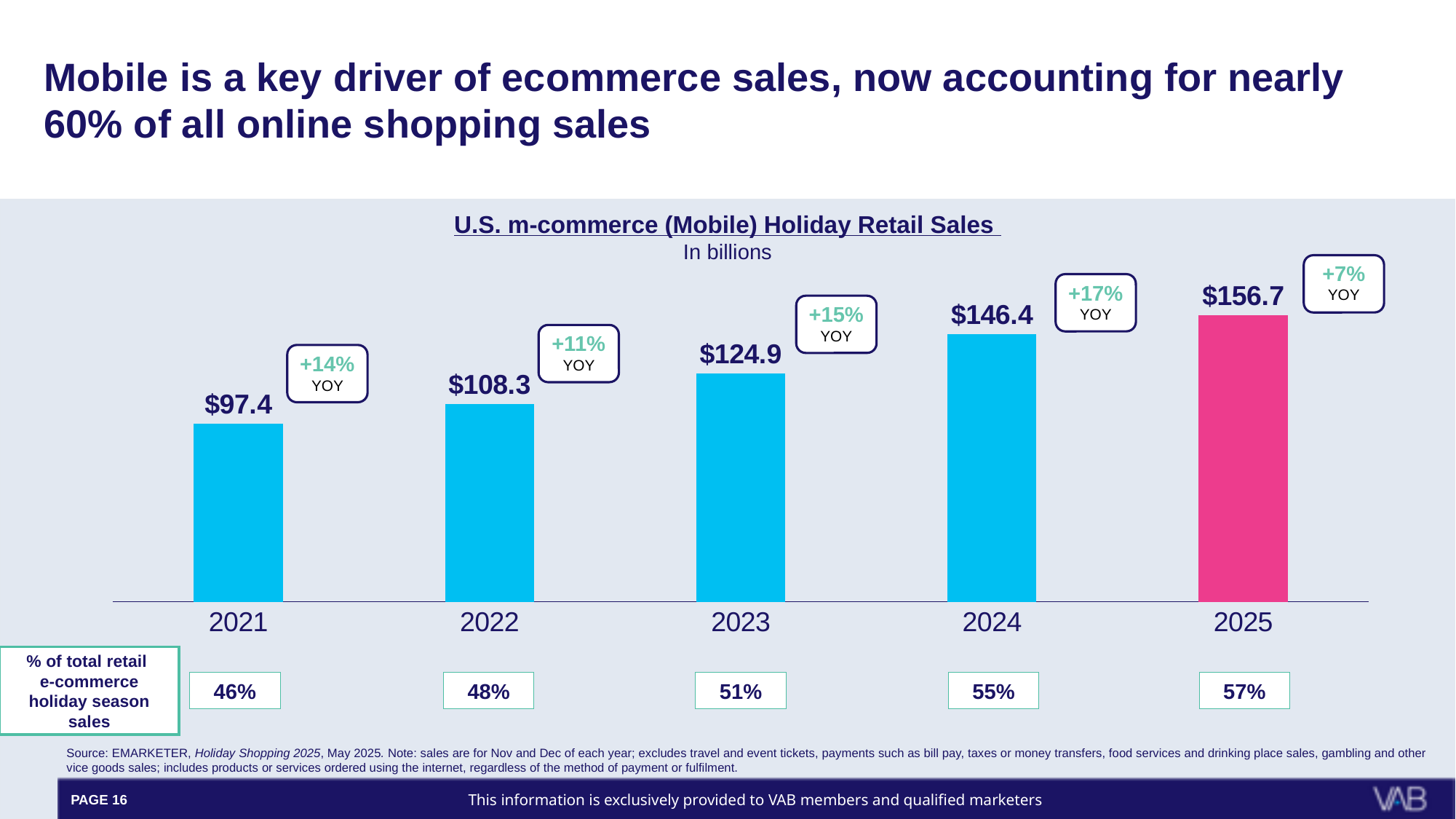
What is the value for 2023 in the U.S. m-commerce (Mobile) Holiday Retail Sales chart? $124.9 Which is larger in the U.S. m-commerce (Mobile) Holiday Retail Sales chart, the value for 2022 or the value for 2024? 2024 Which year has the lowest value in the U.S. m-commerce (Mobile) Holiday Retail Sales chart? 2021 What is the value for 2025 in the U.S. m-commerce (Mobile) Holiday Retail Sales chart? $156.7 What kind of chart is the U.S. m-commerce (Mobile) Holiday Retail Sales chart? Bar chart How many years are shown in the U.S. m-commerce (Mobile) Holiday Retail Sales chart? 5 What is the value for 2021 in the U.S. m-commerce (Mobile) Holiday Retail Sales chart? $97.4 Which year has the highest value in the U.S. m-commerce (Mobile) Holiday Retail Sales chart? 2025 What is the difference between the 2024 and 2023 values in the U.S. m-commerce (Mobile) Holiday Retail Sales chart? $21.5 Do the values in the U.S. m-commerce (Mobile) Holiday Retail Sales chart rise or fall from 2021 to 2025? Rise What percentage of total retail e-commerce holiday season sales does mobile account for in 2025? 57% What is the YOY growth shown for 2024 in the U.S. m-commerce (Mobile) Holiday Retail Sales chart? +17%